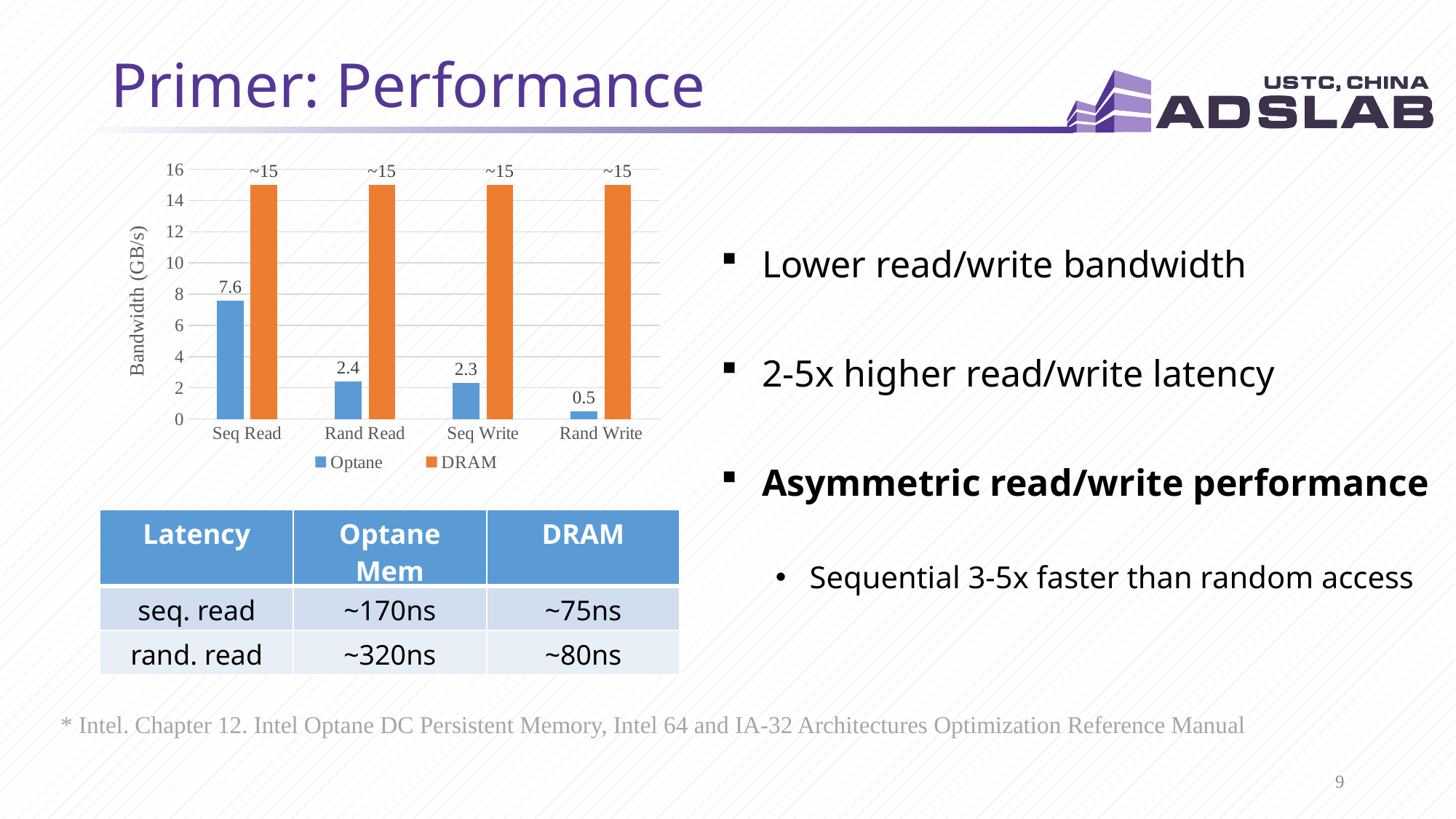
How many series does the chart legend list? 2 What is the Optane bandwidth for Seq Read? 7.6 What is the difference between the Optane bandwidth for Seq Read and for Rand Read? 5.2 What is the Optane bandwidth for Rand Write? 0.5 Which category has the highest Optane bandwidth? Seq Read What value is labelled on the DRAM bar for Seq Write? ~15 What kind of chart is shown on the slide? bar chart Which is larger, the Optane bandwidth for Seq Read or for Seq Write? Seq Read Is the DRAM bandwidth for Rand Write greater or less than 14? greater How many categories are shown on the x axis of the bar chart? 4 Which category has the lowest Optane bandwidth? Rand Write What is the Optane bandwidth for Rand Read? 2.4